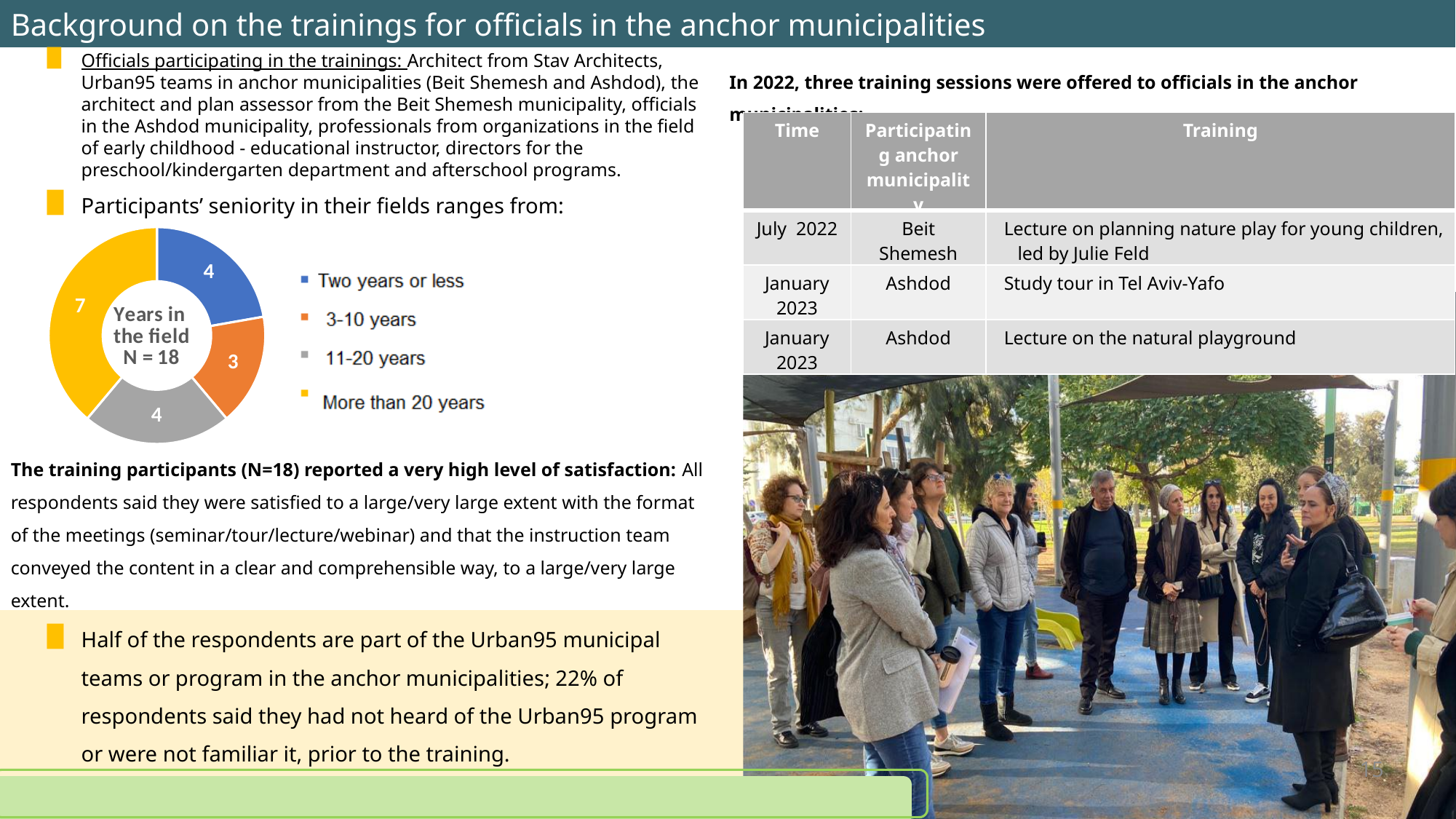
How many participants have 3-10 years in the field? 3 Which seniority category has the most participants? More than 20 years What is the N value shown in the centre of the donut chart? N = 18 How many participants have 11-20 years in the field? 4 What is the difference between the number of participants with more than 20 years and those with 3-10 years? 4 What kind of chart is used to show participants' years in the field? Pie chart (donut) How many seniority categories does the chart show? 4 How many participants have more than 20 years in the field? 7 Which has more participants: 'More than 20 years' or 'Two years or less'? More than 20 years What share of the participants have more than 20 years in the field? 7 of 18 Which seniority category has the fewest participants? 3-10 years How many participants have two years or less in the field? 4